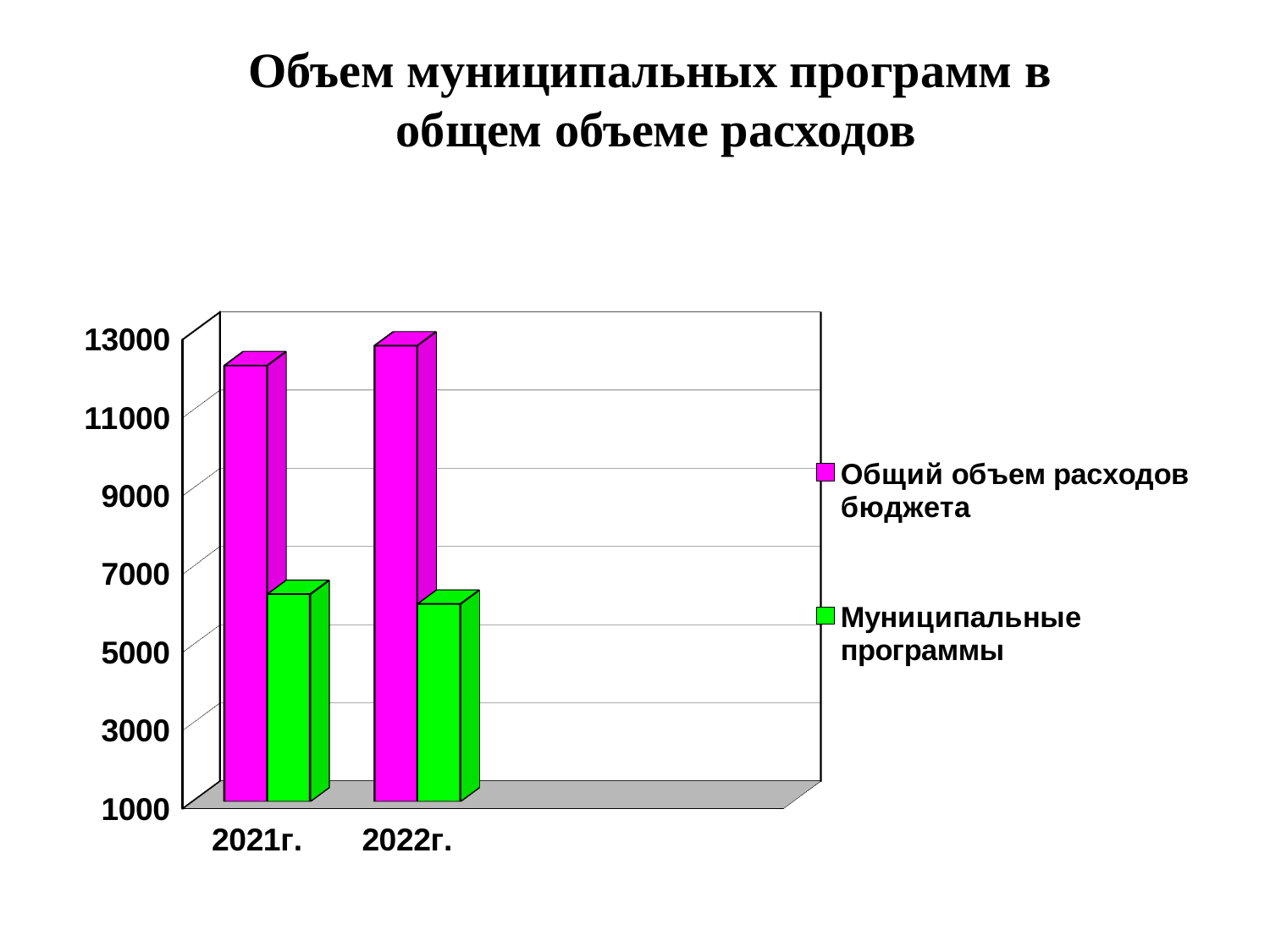
In 2022г., which is larger: Общий объем расходов бюджета or Муниципальные программы? Общий объем расходов бюджета What kind of chart is shown on the slide? bar chart How many categories are shown on the x axis? 2 Is the value for Общий объем расходов бюджета in 2022г. greater or less than 11000? greater Is the value for Общий объем расходов бюджета in 2021г. greater or less than 11000? greater How many series does the legend list? 2 Is the value for Муниципальные программы in 2021г. greater or less than 7000? less Does the value for Общий объем расходов бюджета rise or fall from 2021г. to 2022г.? rise Which series is shown in green? Муниципальные программы In 2021г., which is larger: Общий объем расходов бюджета or Муниципальные программы? Общий объем расходов бюджета What is the title of the chart? Объем муниципальных программ в общем объеме расходов